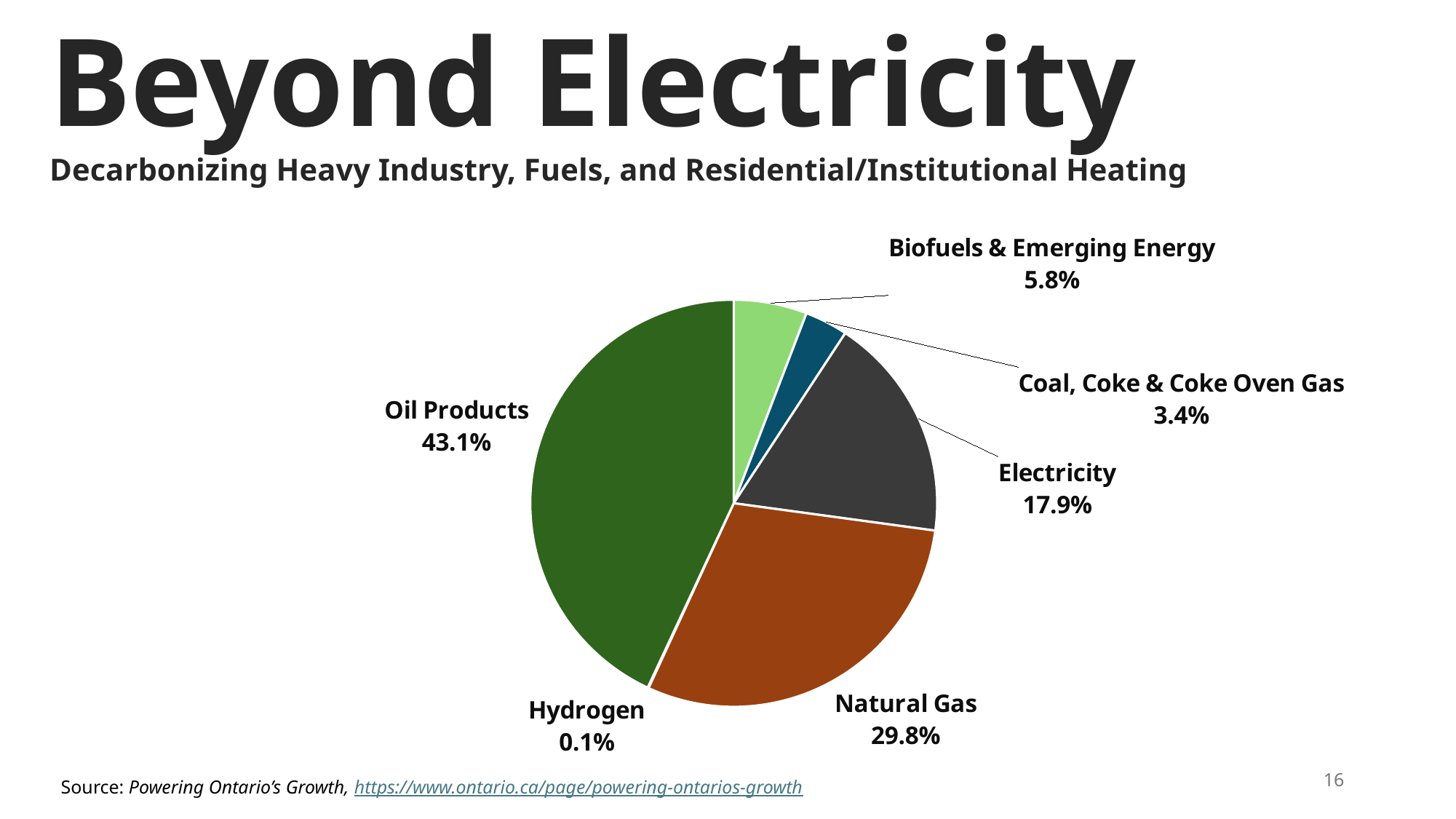
What kind of chart is shown on the slide? Pie chart What is the value shown for Electricity? 17.9% Which category has the smallest share of the pie? Hydrogen Which category has the largest share of the pie? Oil Products What colour is the Natural Gas slice? Brown What is the difference between the shares of Oil Products and Natural Gas? 13.3% What is the value shown for Biofuels & Emerging Energy? 5.8% What share of the pie does Oil Products account for? 43.1% What is the value shown for Natural Gas? 29.8% How many categories are shown in the pie chart? 6 Which is larger, the share for Electricity or the share for Biofuels & Emerging Energy? Electricity What is the value shown for Coal, Coke & Coke Oven Gas? 3.4%